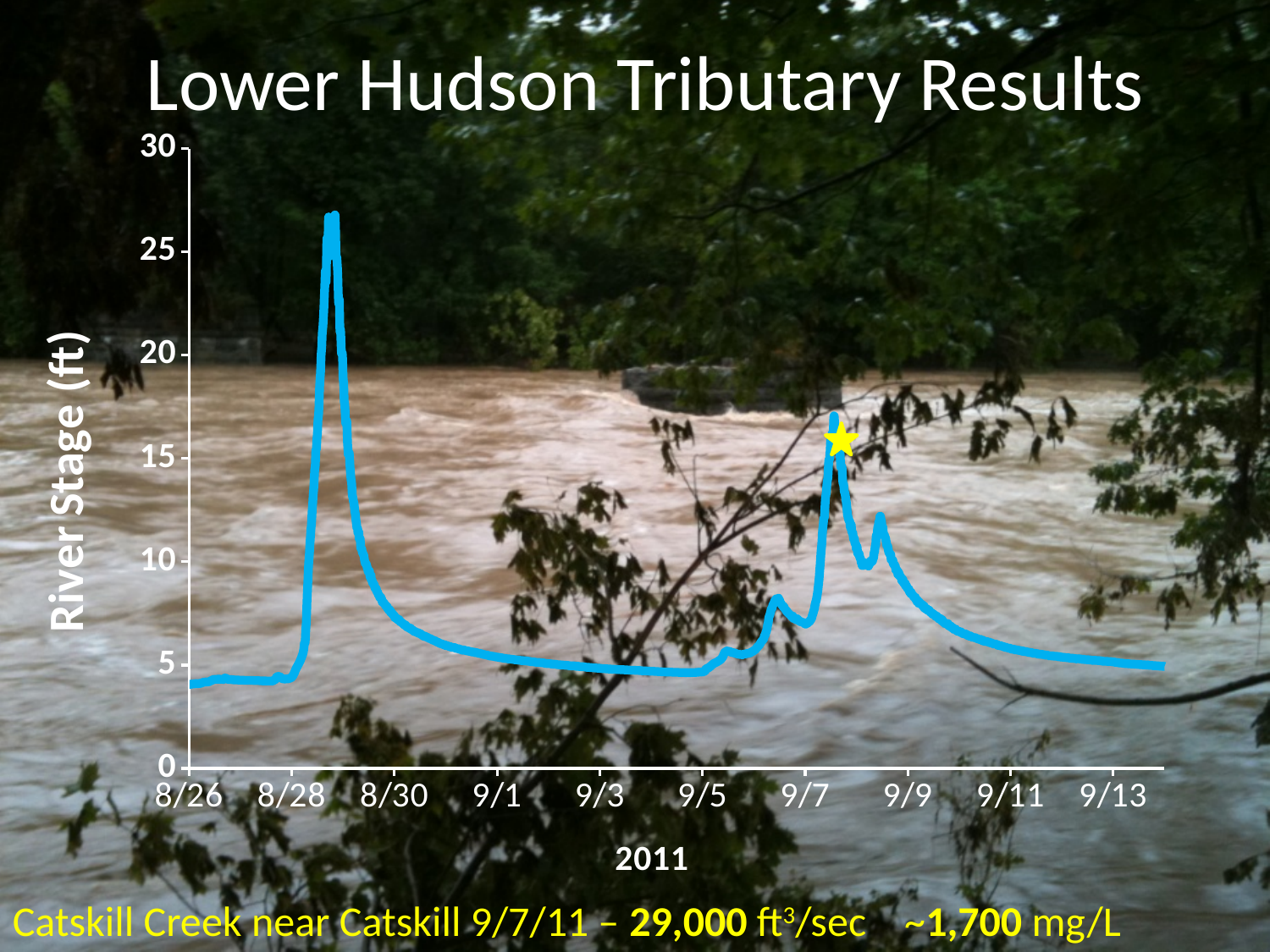
Is the river stage on 9/3 greater or less than 10 ft? less Does the river stage rise or fall between 9/9 and 9/13? fall What is the highest value shown on the vertical axis of the chart? 30 What is the title of the chart on the slide? Lower Hudson Tributary Results Is the river stage on 9/13 greater or less than 10 ft? less Does the highest river stage on the chart occur in late August or in early September? late August How many date labels are shown along the x axis of the chart? 10 Is the peak river stage reached between 8/28 and 8/30 greater or less than 25 ft? greater Which peak is higher: the one in late August (between 8/28 and 8/30) or the one in early September (around 9/7)? the late August peak What kind of chart is shown on the slide? line chart What is the label on the vertical axis of the chart? River Stage (ft)